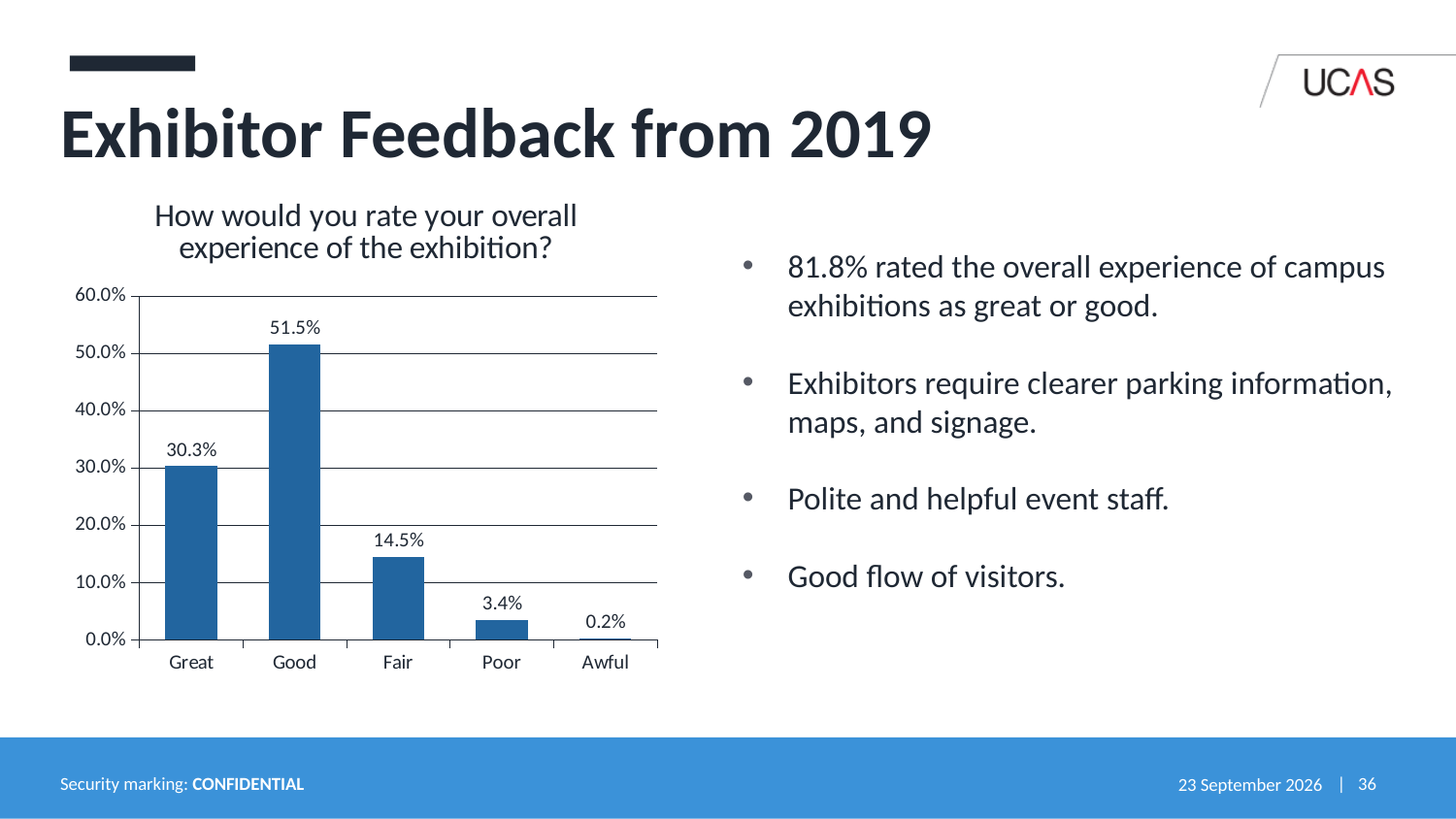
What is the title of the chart? How would you rate your overall experience of the exhibition? What is the value shown for the Awful category? 0.2% How many rating categories are shown on the x axis? 5 What type of chart is shown on the slide? Bar chart What is the difference between the Good and Great percentages? 21.2% What percentage of exhibitors rated their overall experience as Good? 51.5% Is the value for Great greater or less than 40.0%? less What is the value shown for the Fair category? 14.5% What percentage of exhibitors rated their overall experience as Great? 30.3% Which is larger, the value for Fair or the value for Poor? Fair Which rating category has the lowest value? Awful Which rating category has the highest value? Good